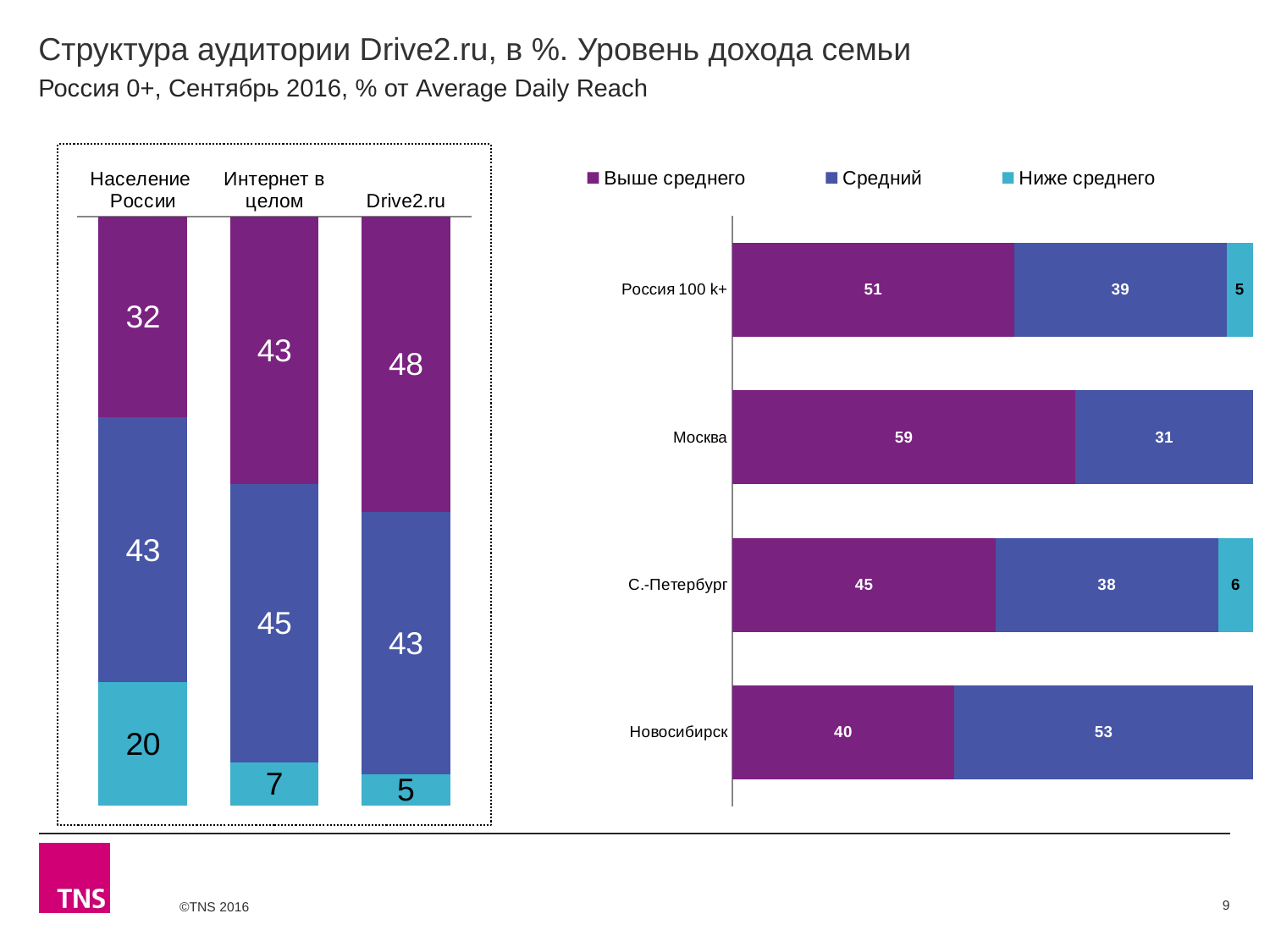
In the right chart, what is the total of the labelled segments for Россия 100 k+? 95 In the left chart, what is the value of the bottom (light blue) segment for Население России? 20 In the right chart, which is larger: the Средний value for Россия 100 k+ or for С.-Петербург? Россия 100 k+ How many series does the legend of the right chart list? 3 In the right chart, what is the Выше среднего value for Москва? 59 In the right chart, which category has the highest Выше среднего value? Москва In the left chart, what is the difference between the top (purple) segments of Drive2.ru and Население России? 16 In the left chart, what is the value of the top (purple) segment for Drive2.ru? 48 In the right chart, what is the Средний value for Новосибирск? 53 In the left chart, what is the value of the middle (blue) segment for Интернет в целом? 45 In the left chart, which column has the largest bottom (light blue) segment? Население России In the left chart, how many columns are shown? 3